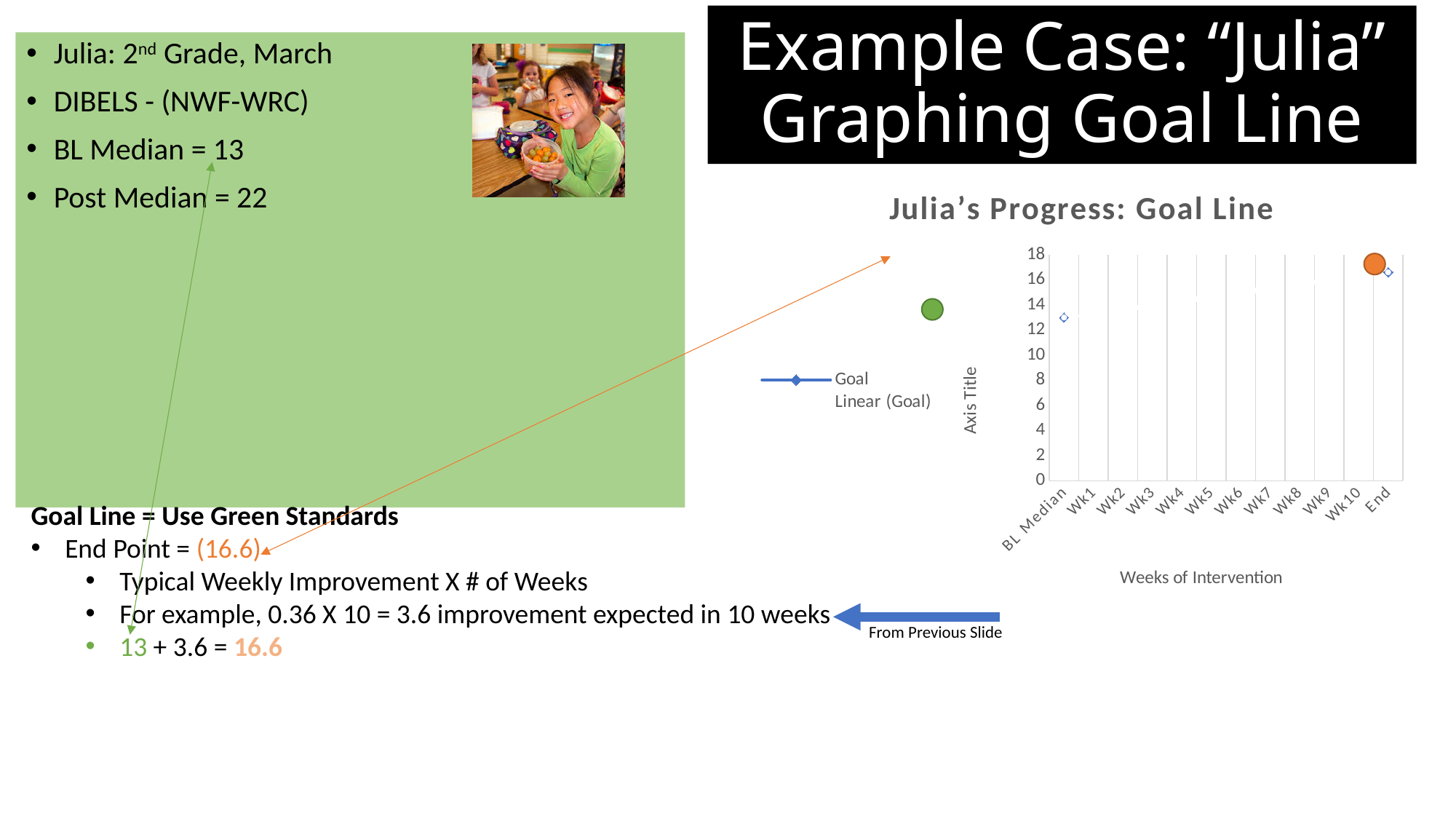
Which category has the lowest plotted value on the chart? BL Median How many categories are shown along the x axis of the chart? 12 According to the slide, what is the value of the End point on the goal line? 16.6 What is the x-axis title of the chart? Weeks of Intervention Do the plotted values rise or fall from BL Median to End? rise How many entries does the chart's legend list? 2 What kind of chart is "Julia's Progress: Goal Line"? line chart Which plotted point is higher, BL Median or End? End Is the value plotted for End greater or less than 16? greater What is the title of the chart on the slide? Julia's Progress: Goal Line Is the value plotted for BL Median greater or less than 12? greater Is the value plotted for BL Median greater or less than 14? less